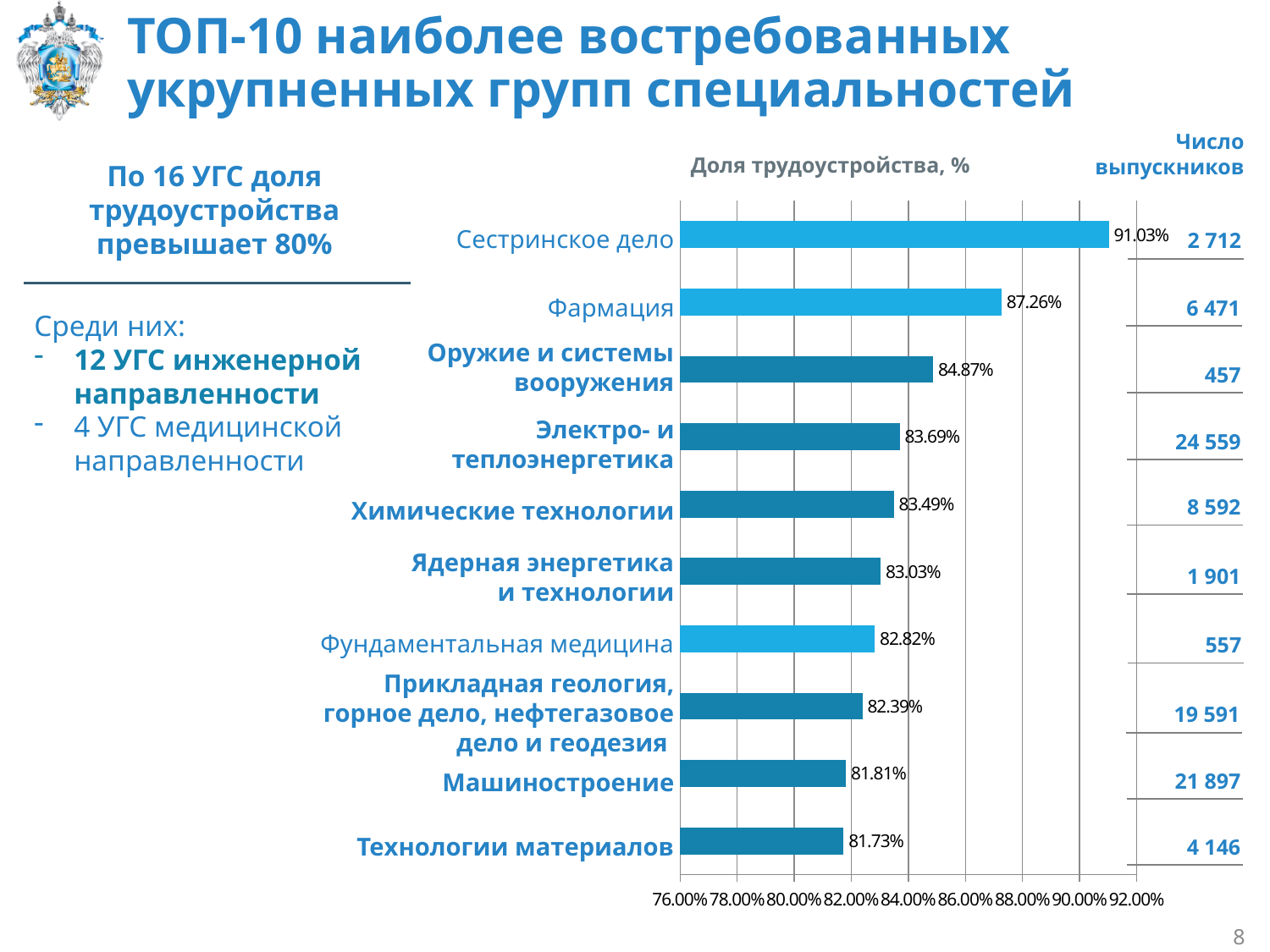
Which has a higher employment share, Химические технологии or Ядерная энергетика и технологии? Химические технологии How many categories are shown in the chart? 10 What is the employment share (Доля трудоустройства) for Сестринское дело? 91.03% What is the employment share for Прикладная геология, горное дело, нефтегазовое дело и геодезия? 82.39% What is the title of the chart's value axis shown above the bars? Доля трудоустройства, % What is the employment share for Машиностроение? 81.81% Is the employment share for Оружие и системы вооружения greater or less than 84.00%? greater Which category has the highest employment share? Сестринское дело Which category has the lowest employment share? Технологии материалов What is the employment share for Фармация? 87.26% What kind of chart is shown on the slide? Bar chart What is the difference in employment share between Сестринское дело and Фармация? 3.77%